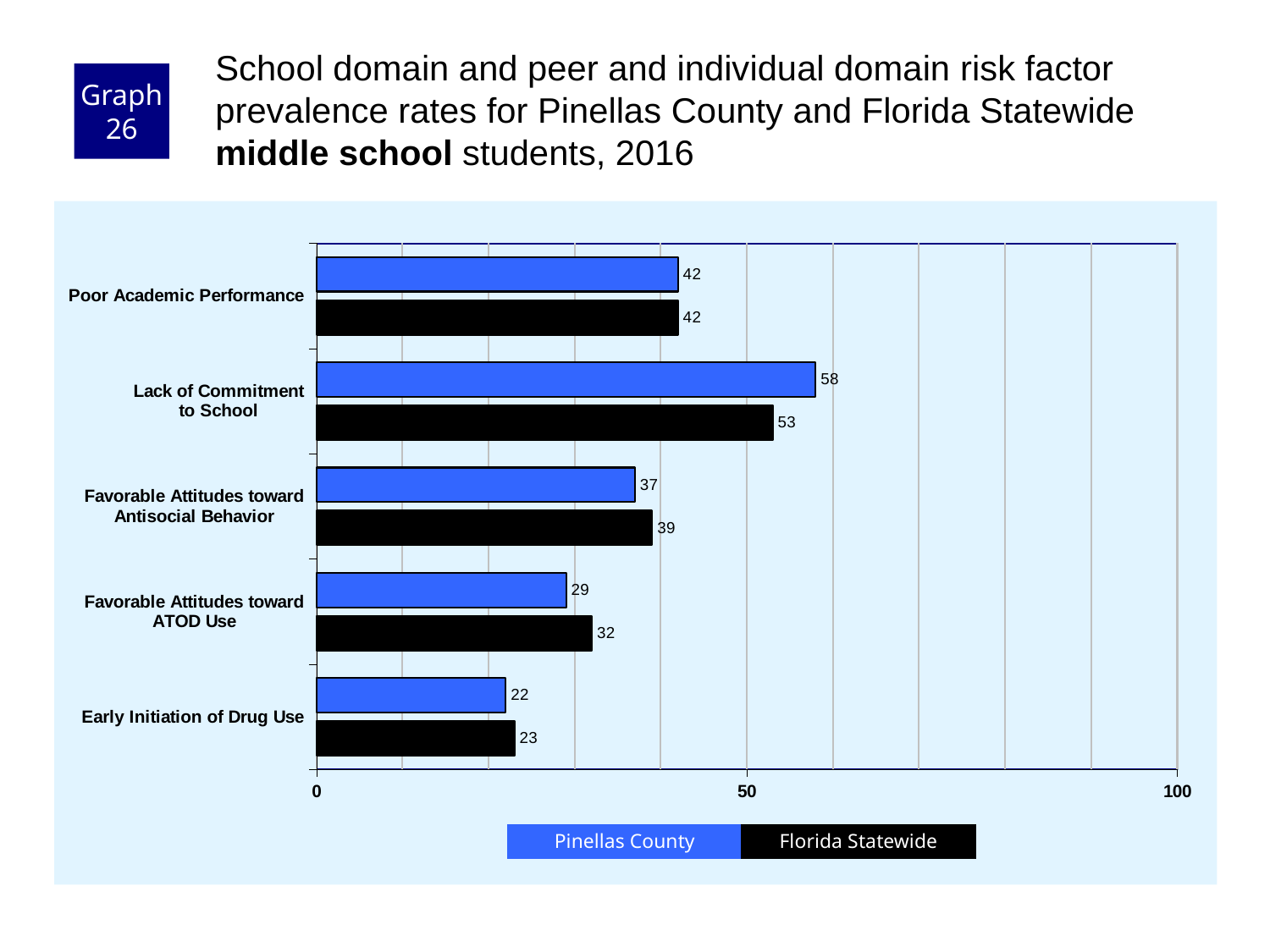
For Favorable Attitudes toward Antisocial Behavior, which is larger: the Pinellas County value or the Florida Statewide value? Florida Statewide Which risk factor has the highest Pinellas County value? Lack of Commitment to School What is the Pinellas County value for Lack of Commitment to School? 58 What is the Florida Statewide value for Favorable Attitudes toward ATOD Use? 32 How many risk factor categories are shown in the chart? 5 How many series does the legend list? 2 Which risk factor has the lowest Florida Statewide value? Early Initiation of Drug Use Which colour represents Florida Statewide in the chart? black What kind of chart is shown on the slide? bar chart Is the Pinellas County value for Lack of Commitment to School greater or less than 50? greater What is the difference between the Pinellas County and Florida Statewide values for Lack of Commitment to School? 5 What is the Pinellas County value for Early Initiation of Drug Use? 22